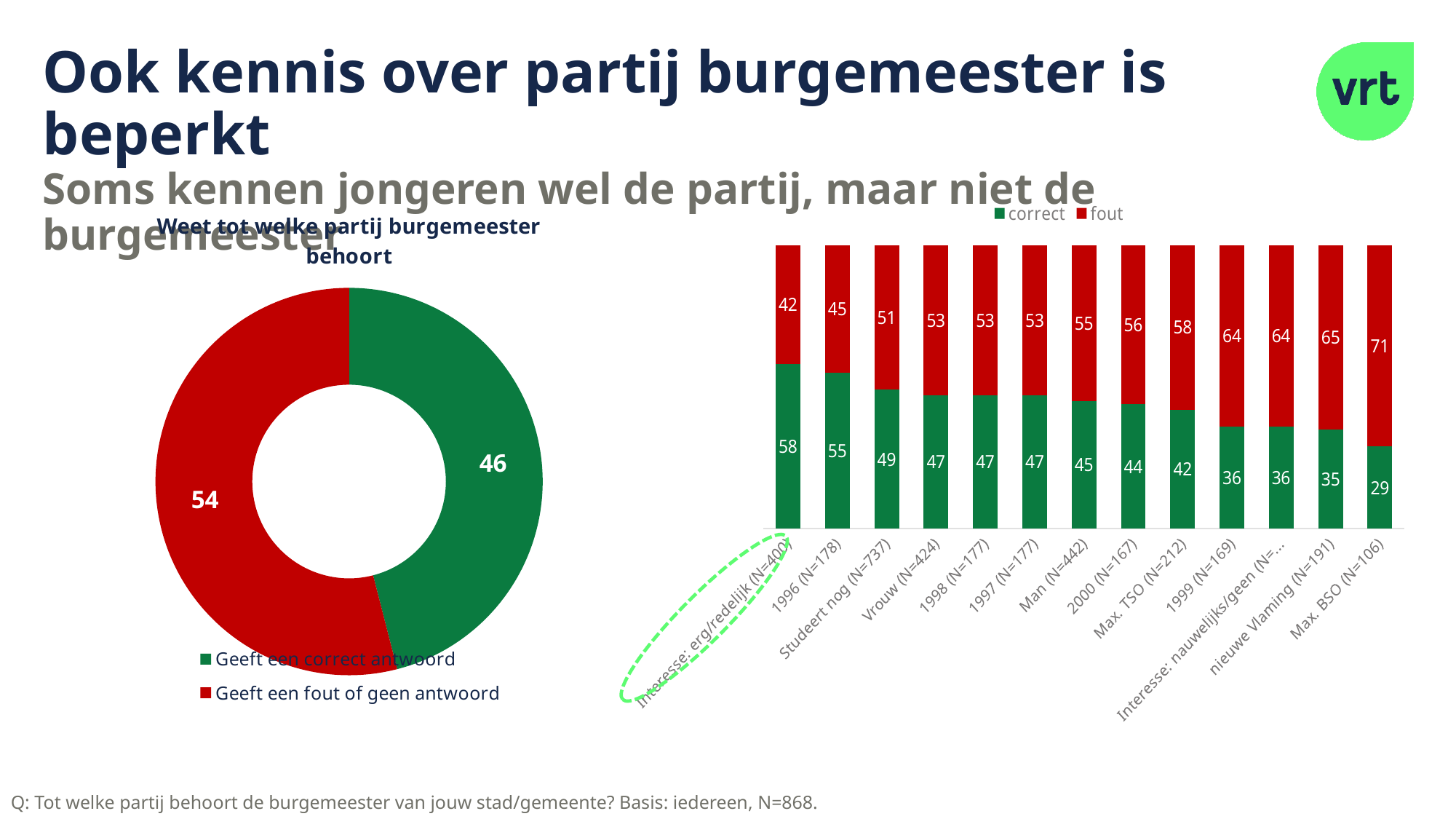
In the stacked bar chart on the right, what is the 'fout' value for Man (N=442)? 55 In the donut chart on the left, what value is shown for the red 'Geeft een fout of geen antwoord' slice? 54 In the stacked bar chart on the right, what is the 'correct' value for Max. BSO (N=106)? 29 In the stacked bar chart on the right, what is the difference between the 'correct' values for Vrouw (N=424) and Man (N=442)? 2 In the stacked bar chart on the right, what is the total of the stacked bar for 1996 (N=178)? 100 What type of chart is the chart on the left of the slide? Donut (pie) chart In the stacked bar chart on the right, which category has the lowest 'correct' value? Max. BSO (N=106) In the stacked bar chart on the right, which category has the highest 'correct' value? Interesse: erg/redelijk (N=400) How many categories are shown on the x axis of the stacked bar chart on the right? 13 In the donut chart on the left, what value is shown for the green 'Geeft een correct antwoord' slice? 46 In the donut chart on the left, which slice is larger: 'Geeft een correct antwoord' or 'Geeft een fout of geen antwoord'? Geeft een fout of geen antwoord How many series does the legend of the stacked bar chart on the right list? 2